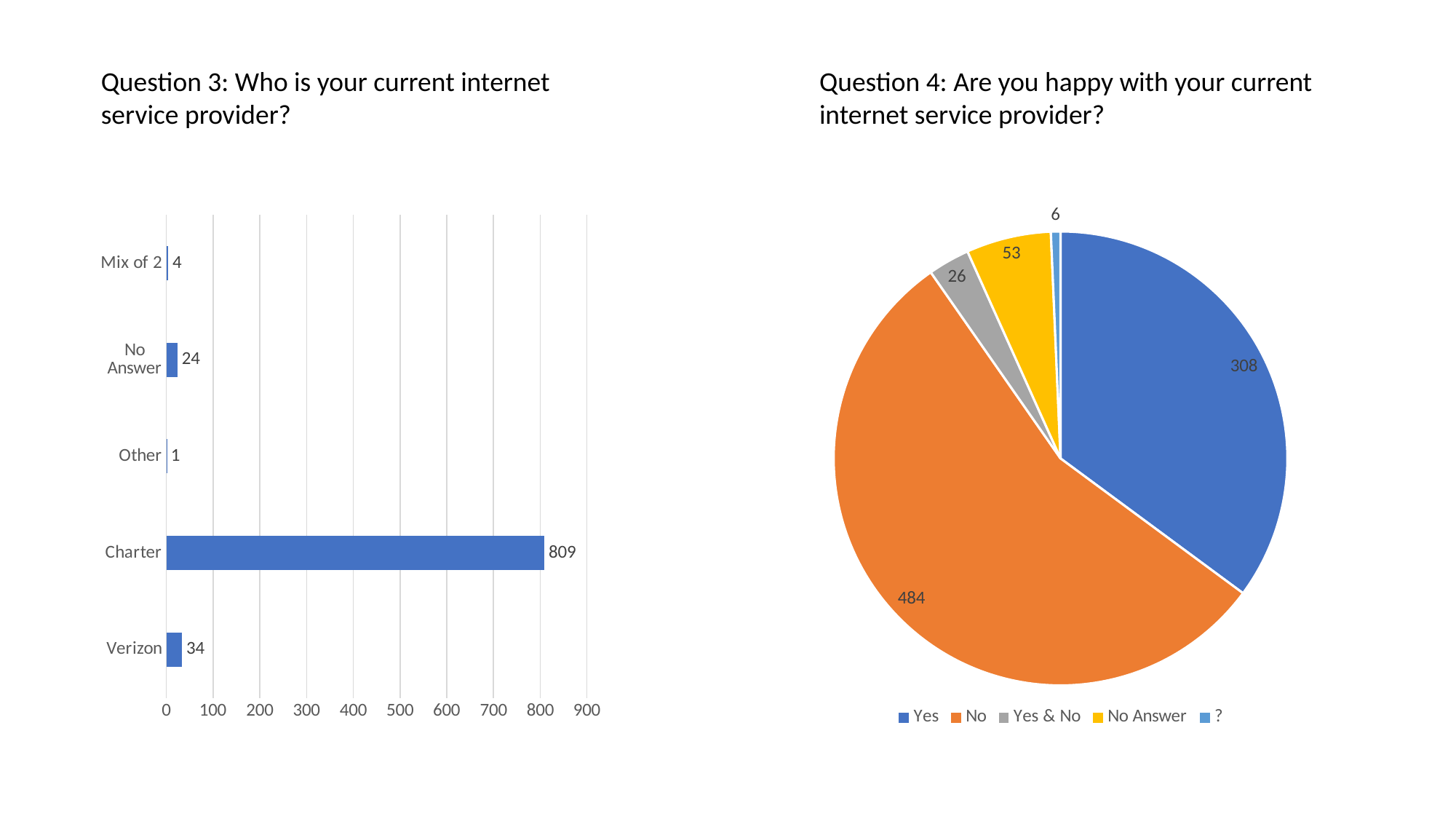
In the Question 3 chart on the left, what is the value for Verizon? 34 In the Question 3 chart on the left, what is the difference between the values for Charter and Verizon? 775 In the Question 4 pie chart on the right, what is the value for No? 484 In the Question 3 chart on the left, which provider has the lowest value? Other In the Question 4 pie chart on the right, how many entries does the legend list? 5 What kind of chart is the Question 3 chart on the left? Bar chart In the Question 3 chart on the left, what is the value for Charter? 809 In the Question 4 pie chart on the right, which response has the largest slice? No In the Question 3 chart on the left, which is larger, the value for No Answer or the value for Verizon? Verizon In the Question 4 pie chart on the right, what is the difference between the values for No and Yes? 176 In the Question 3 chart on the left, how many categories are shown? 5 In the Question 4 pie chart on the right, what is the value for Yes & No? 26